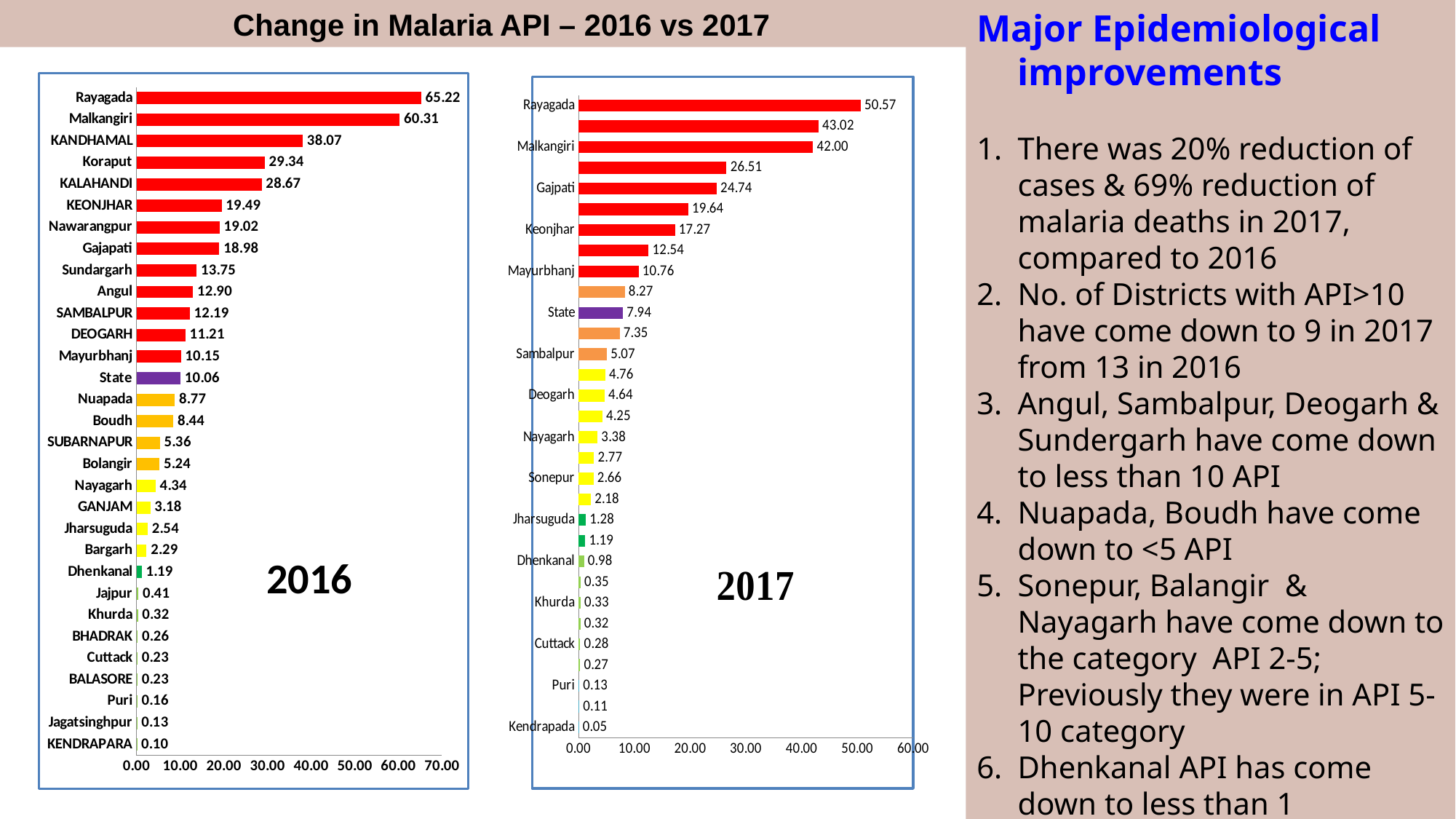
In the 2017 chart, is the value for Keonjhar greater or less than 20.00? less In the 2016 chart, which has a larger value, Nuapada or Boudh? Nuapada In the 2016 chart, which category has the lowest value? KENDRAPARA In the 2017 chart, what is the value for the State bar? 7.94 In the 2016 chart, what is the value shown for the State bar? 10.06 In the 2016 chart, what is the malaria API value for Rayagada? 65.22 How many bars are plotted in the 2016 chart? 31 In the 2016 chart, what is the difference between the values for Rayagada and Malkangiri? 4.91 What is the title shown above the two charts? Change in Malaria API – 2016 vs 2017 In the 2017 chart, what is the value for Rayagada? 50.57 In the 2017 chart, which category has the highest value? Rayagada What type of chart is the 2017 chart? bar chart